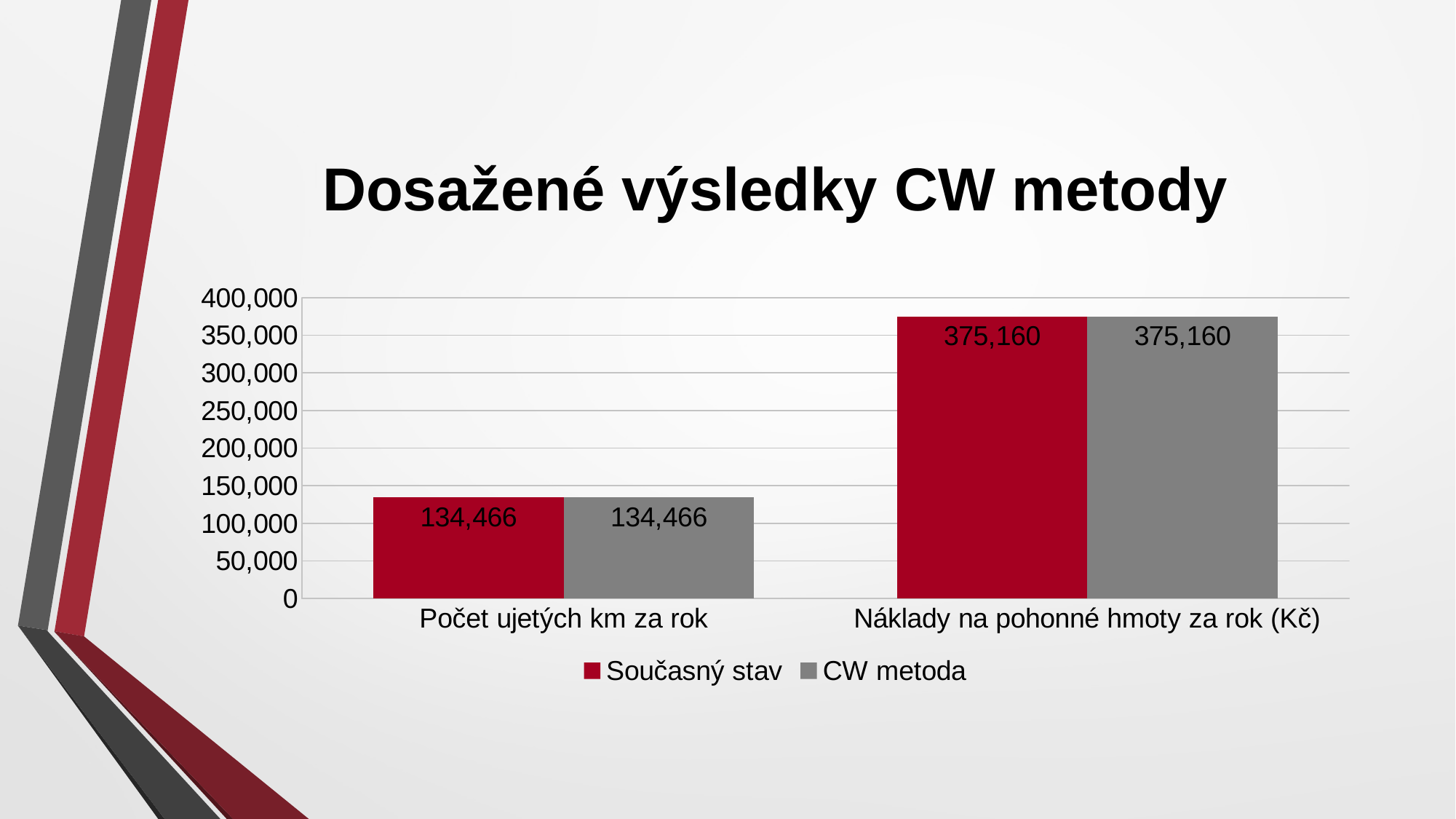
What is the value for Současný stav in the category Náklady na pohonné hmoty za rok (Kč)? 375,160 What is the title of the chart? Dosažené výsledky CW metody How many series does the legend list? 2 What is the value for Současný stav in the category Počet ujetých km za rok? 134,466 What is the difference between the Současný stav values for Náklady na pohonné hmoty za rok (Kč) and Počet ujetých km za rok? 240,694 What is the value for CW metoda in the category Počet ujetých km za rok? 134,466 Which category has the lower value for CW metoda? Počet ujetých km za rok How many categories are shown on the x axis? 2 Is the Současný stav value for Náklady na pohonné hmoty za rok (Kč) greater or less than 350,000? greater Which category has the higher value for Současný stav? Náklady na pohonné hmoty za rok (Kč) What is the value for CW metoda in the category Náklady na pohonné hmoty za rok (Kč)? 375,160 What kind of chart is shown on the slide? bar chart